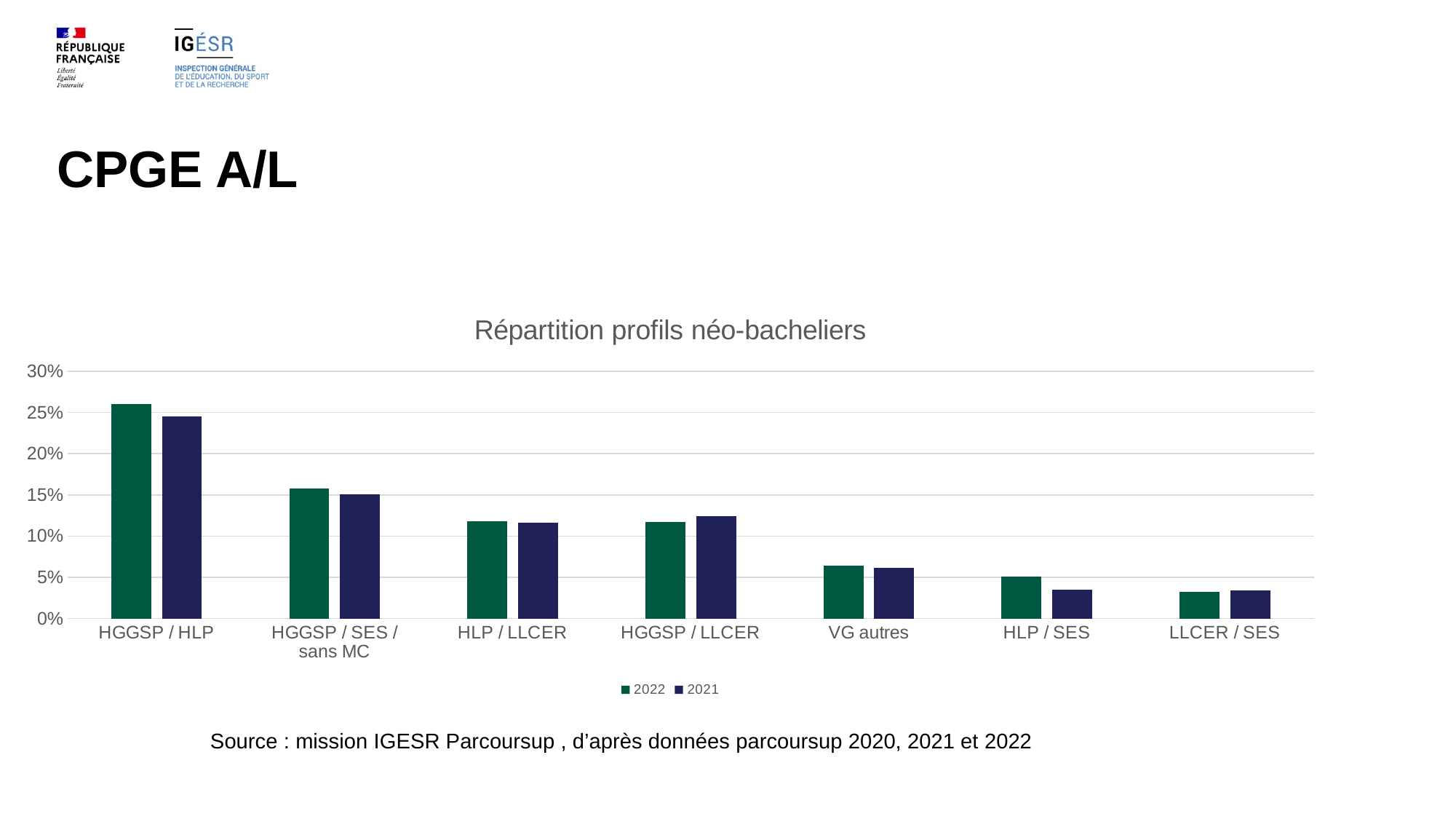
Is the 2022 value for HGGSP / SES / sans MC greater or less than 20%? less Is the 2022 value for HGGSP / HLP greater or less than 20%? greater Is the 2022 value for VG autres greater or less than 5%? greater What kind of chart is shown on the slide? bar chart For HGGSP / LLCER, which year has the larger value, 2022 or 2021? 2021 How many series does the legend list? 2 Which category has the lowest value for 2022? LLCER / SES What is the title of the chart? Répartition profils néo-bacheliers How many profile categories are shown on the x axis? 7 For HGGSP / HLP, which year has the larger value, 2022 or 2021? 2022 Which category has the highest value for 2022? HGGSP / HLP